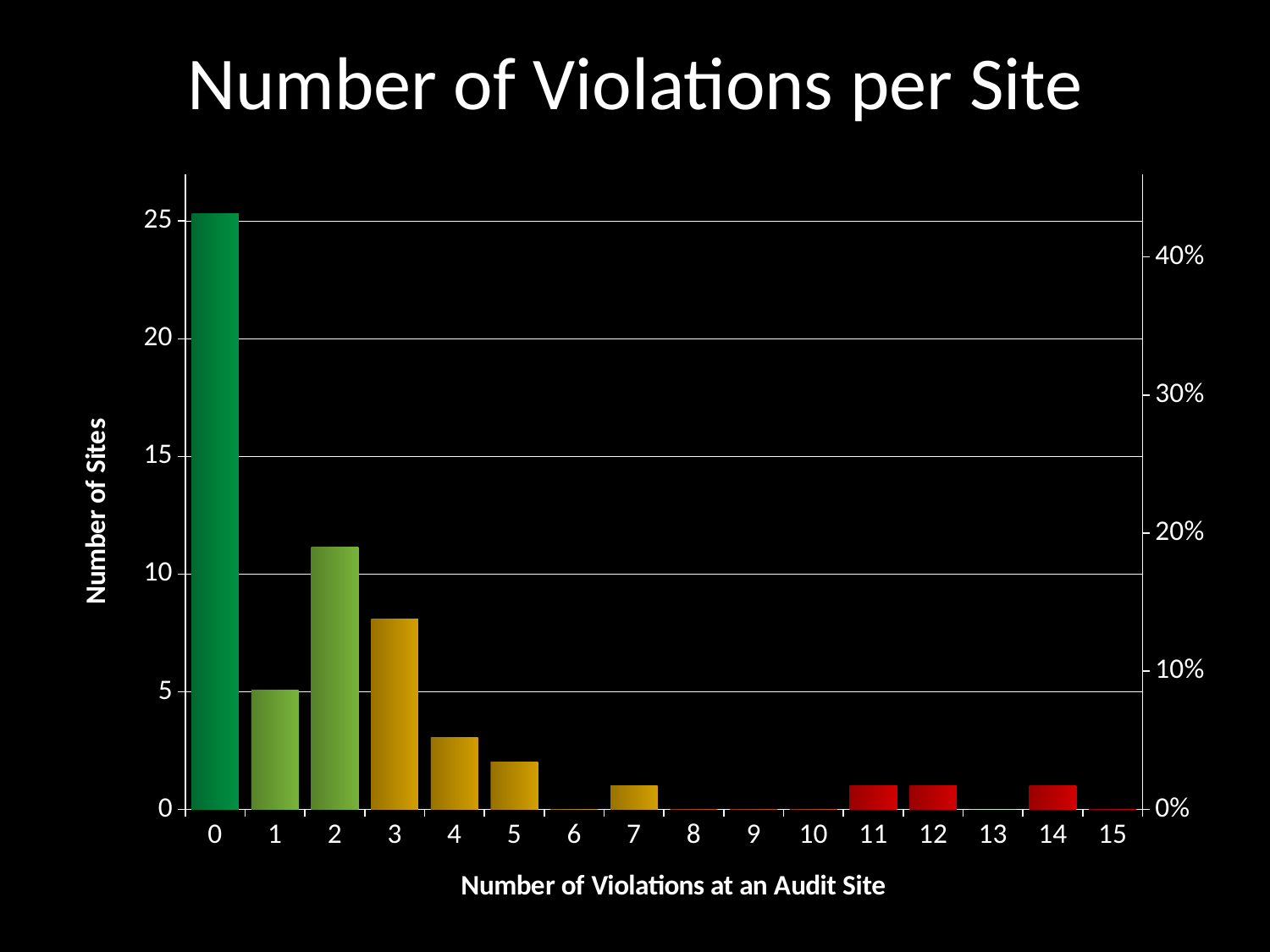
Is the number of sites with 3 violations greater or less than 10? less What kind of chart is shown on the slide? bar chart Which number of violations has the highest number of sites? 0 What is the title of the chart? Number of Violations per Site Which has more sites: 2 violations or 3 violations? 2 violations Is the number of sites with 2 violations greater or less than 10? greater What is the label of the x axis? Number of Violations at an Audit Site Is the number of sites with 4 violations greater or less than 5? less Which has more sites: 1 violation or 2 violations? 2 violations How many categories are shown on the x axis? 16 Which has more sites: 4 violations or 5 violations? 4 violations